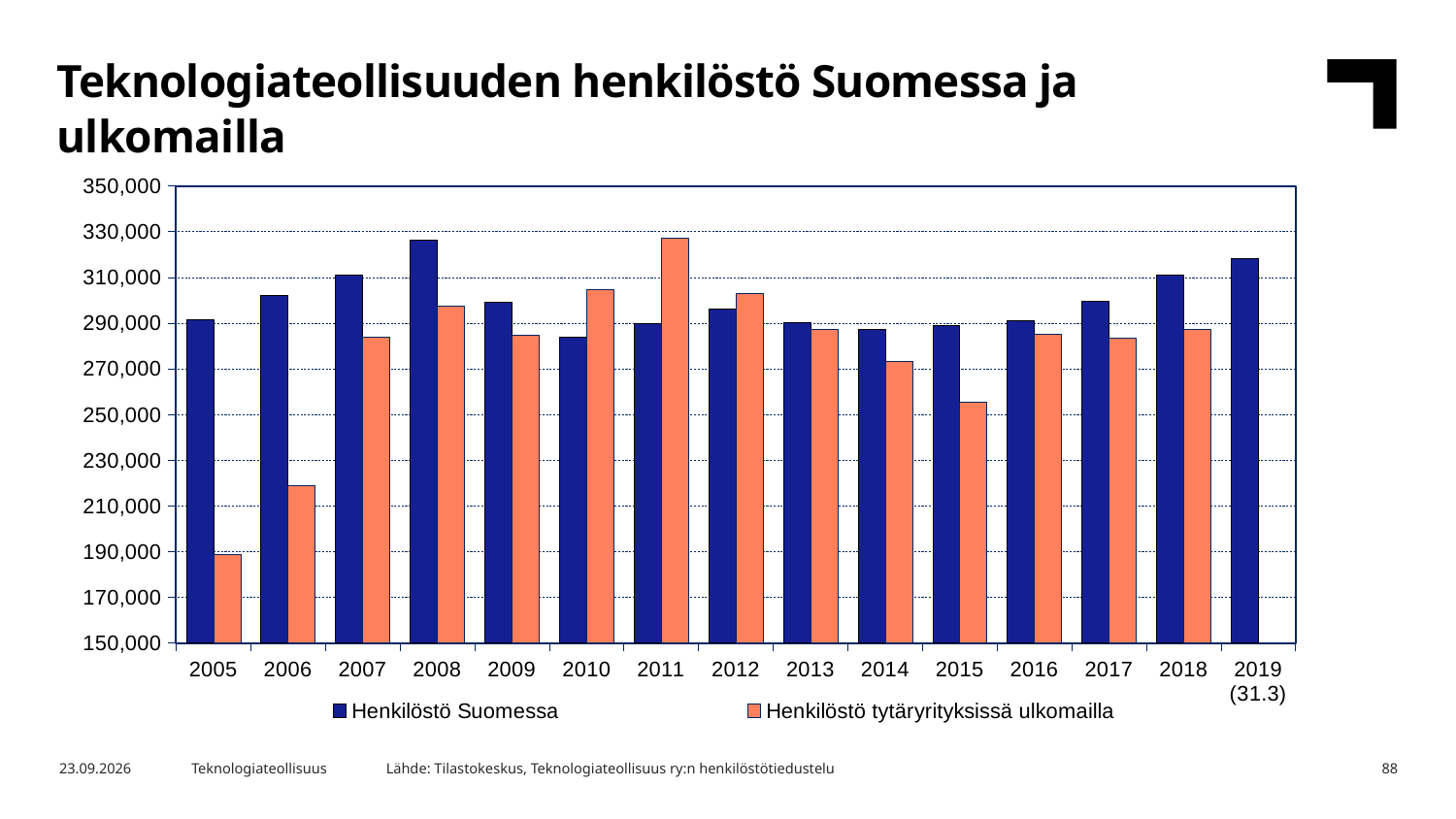
In 2011, which series has the larger value: Henkilöstö Suomessa or Henkilöstö tytäryrityksissä ulkomailla? Henkilöstö tytäryrityksissä ulkomailla Is the value for Henkilöstö Suomessa in 2008 greater or less than 310,000? greater In which year is the value for Henkilöstö tytäryrityksissä ulkomailla lowest? 2005 In which year is the value for Henkilöstö tytäryrityksissä ulkomailla highest? 2011 In 2015, which series has the larger value: Henkilöstö Suomessa or Henkilöstö tytäryrityksissä ulkomailla? Henkilöstö Suomessa Is the value for Henkilöstö tytäryrityksissä ulkomailla in 2006 greater or less than 230,000? less Is the value for Henkilöstö tytäryrityksissä ulkomailla in 2015 greater or less than 270,000? less In which year is the value for Henkilöstö Suomessa highest? 2008 How many series does the legend list? 2 Which year on the x axis has a bar for only one series? 2019 (31.3) How many years are shown on the x axis? 15 What kind of chart is shown on the slide? bar chart